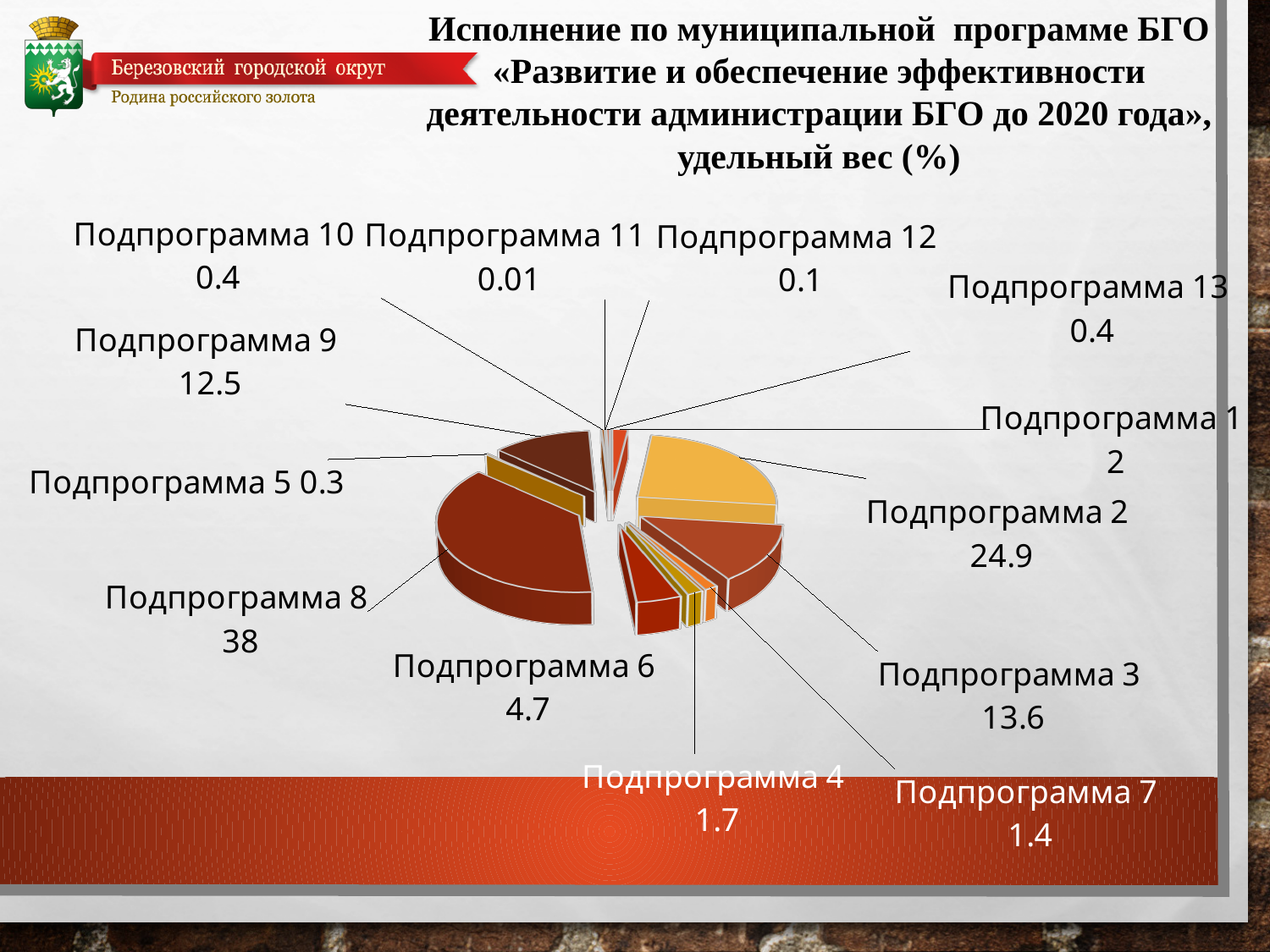
Which subprogram has the smallest value in the chart? Подпрограмма 11 What is the value shown for Подпрограмма 11? 0.01 What is the difference between the values for Подпрограмма 2 and Подпрограмма 3? 11.3 What is the difference between the values for Подпрограмма 8 and Подпрограмма 2? 13.1 Which subprogram has the largest share of the pie? Подпрограмма 8 What type of chart is shown on the slide? Pie chart What is the value shown for Подпрограмма 6? 4.7 How many subprograms (slices) are shown in the pie chart? 13 In what unit are the values in the chart expressed, according to the slide title? % What is the value shown for Подпрограмма 8? 38 Which is larger, the value for Подпрограмма 9 or the value for Подпрограмма 3? Подпрограмма 3 What is the value shown for Подпрограмма 2? 24.9